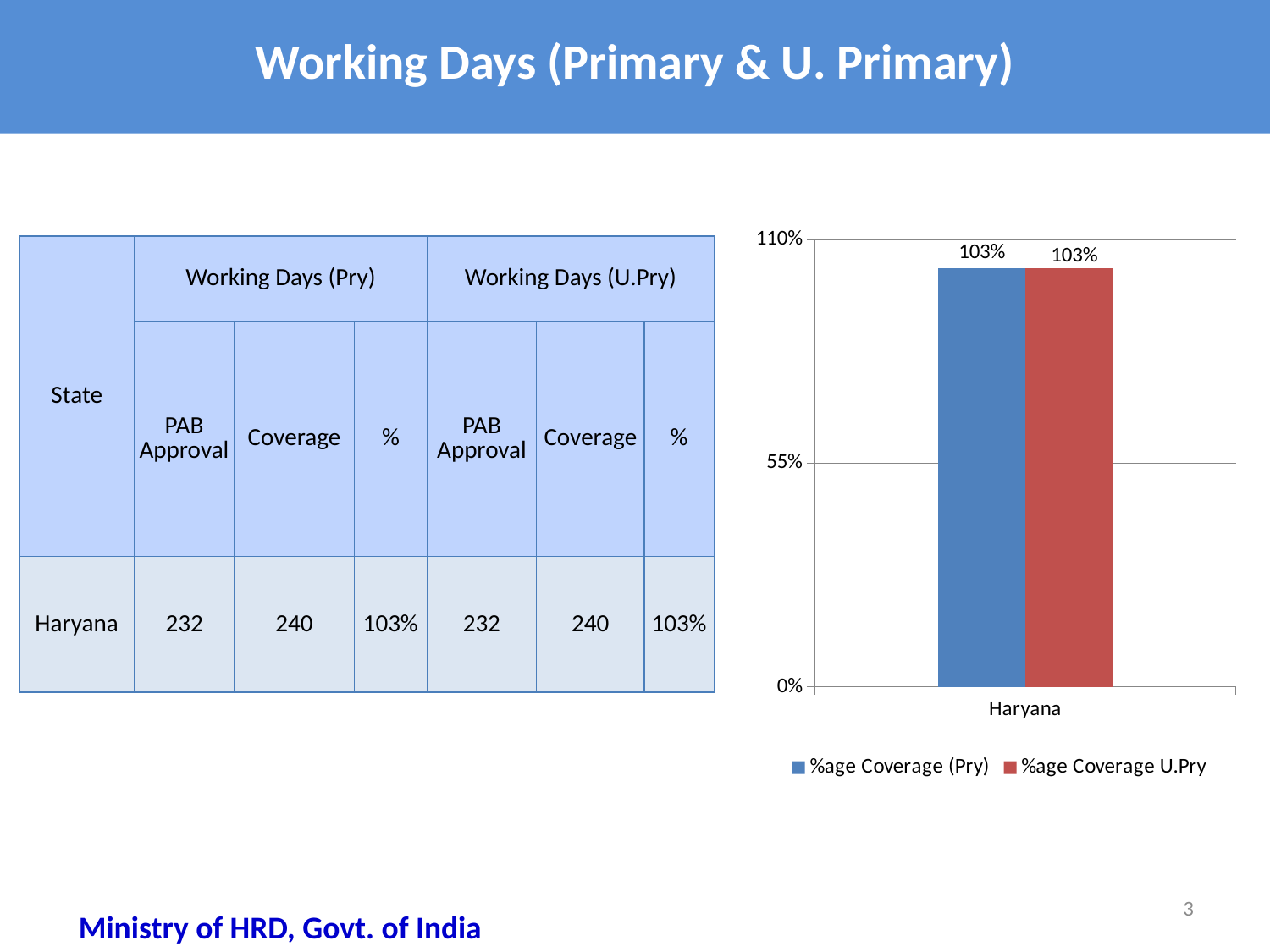
What colour are the %age Coverage U.Pry bars in the chart? red What is the value of %age Coverage U.Pry for Haryana? 103% What is the value of %age Coverage (Pry) for Haryana? 103% Is the value for %age Coverage U.Pry for Haryana greater or less than 110%? less How many series does the chart legend list? 2 How many categories are shown on the x axis of the chart? 1 What kind of chart is shown on the slide? bar chart Which category is shown on the x axis of the chart? Haryana Is the value for %age Coverage (Pry) for Haryana greater or less than 55%? greater What is the difference between %age Coverage (Pry) and %age Coverage U.Pry for Haryana? 0%